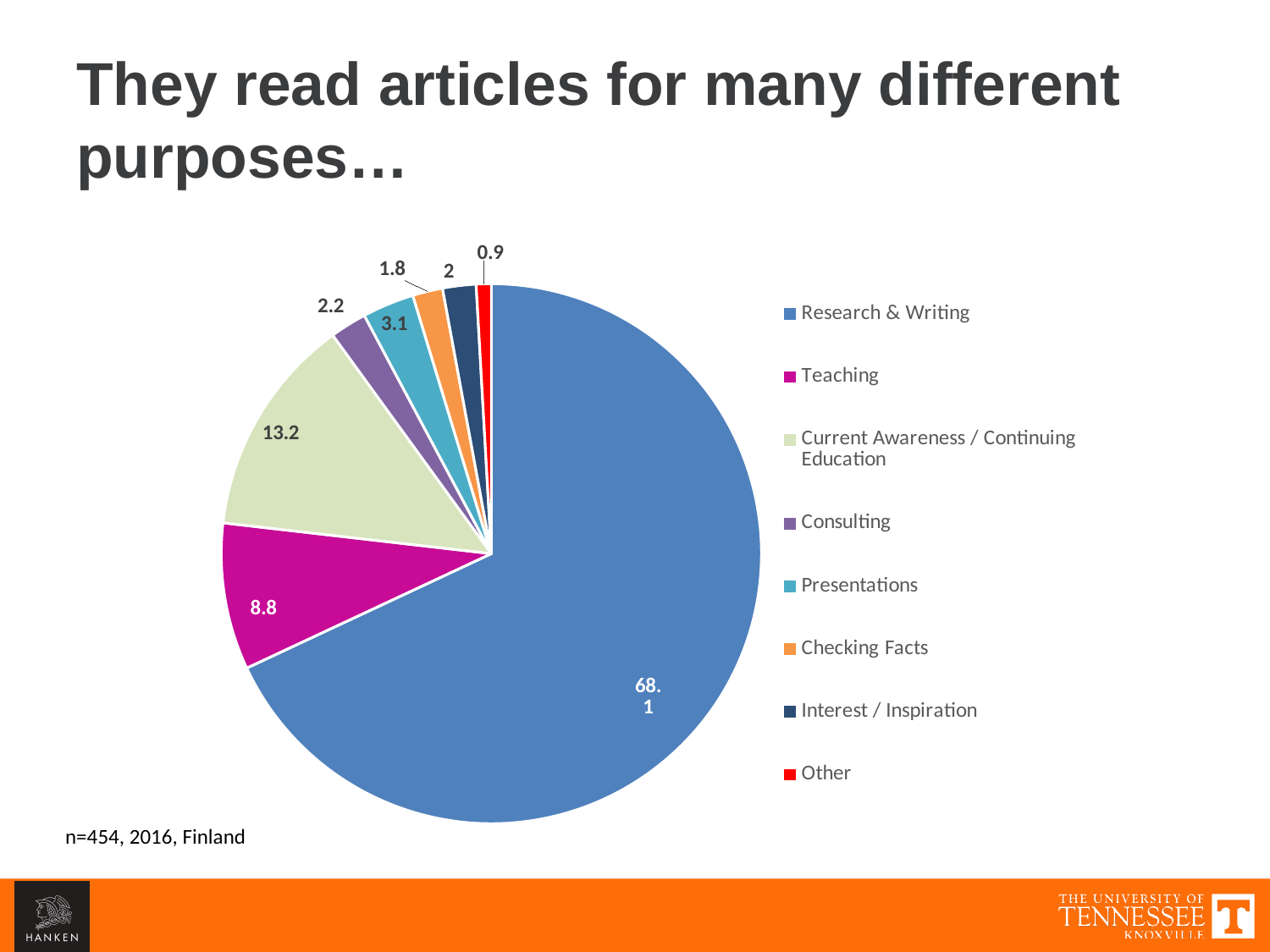
What is the difference between the values for Current Awareness / Continuing Education and Teaching? 4.4 How many categories does the legend list? 8 What is the value for Research & Writing? 68.1 What is the value for Teaching? 8.8 What is the value for Checking Facts? 1.8 What sample size is noted below the chart? n=454, 2016, Finland What kind of chart is shown on the slide? pie chart What is the value for Presentations? 3.1 Which is larger, the value for Consulting or the value for Presentations? Presentations Which category has the smallest slice of the pie? Other Which category has the largest slice of the pie? Research & Writing What is the value for Current Awareness / Continuing Education? 13.2